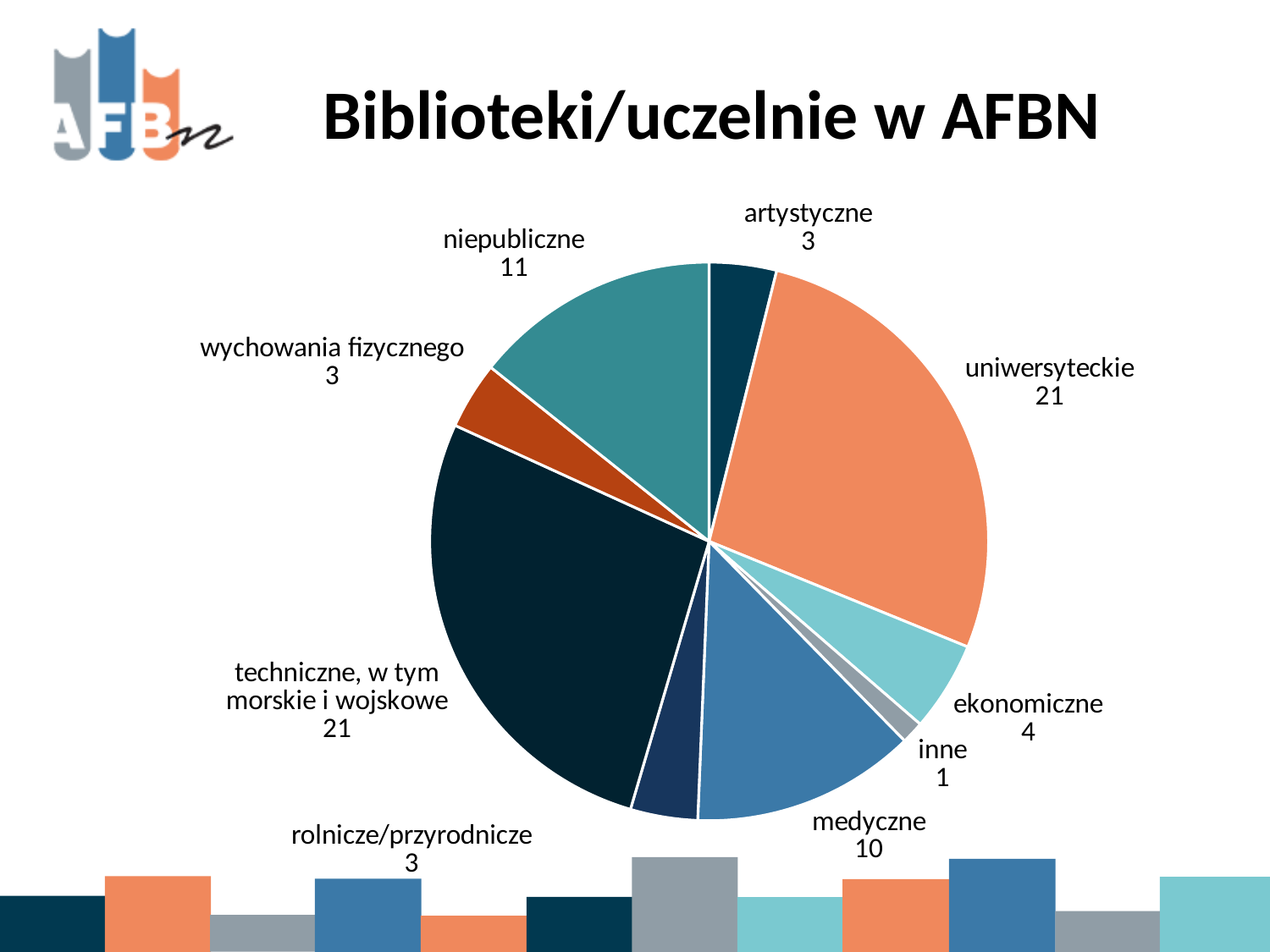
What kind of chart is shown on the slide? pie chart What value is shown for ekonomiczne in the pie chart? 4 What is the title of the slide? Biblioteki/uczelnie w AFBN What value is shown for niepubliczne in the pie chart? 11 What is the difference between the values for niepubliczne and medyczne? 1 What value is shown for medyczne in the pie chart? 10 Which category has the smallest value in the pie chart? inne What value is shown for techniczne, w tym morskie i wojskowe in the pie chart? 21 Which is larger, the value for medyczne or the value for ekonomiczne? medyczne What value is shown for uniwersyteckie in the pie chart? 21 How many categories are shown in the pie chart? 9 What is the difference between the values for uniwersyteckie and ekonomiczne? 17